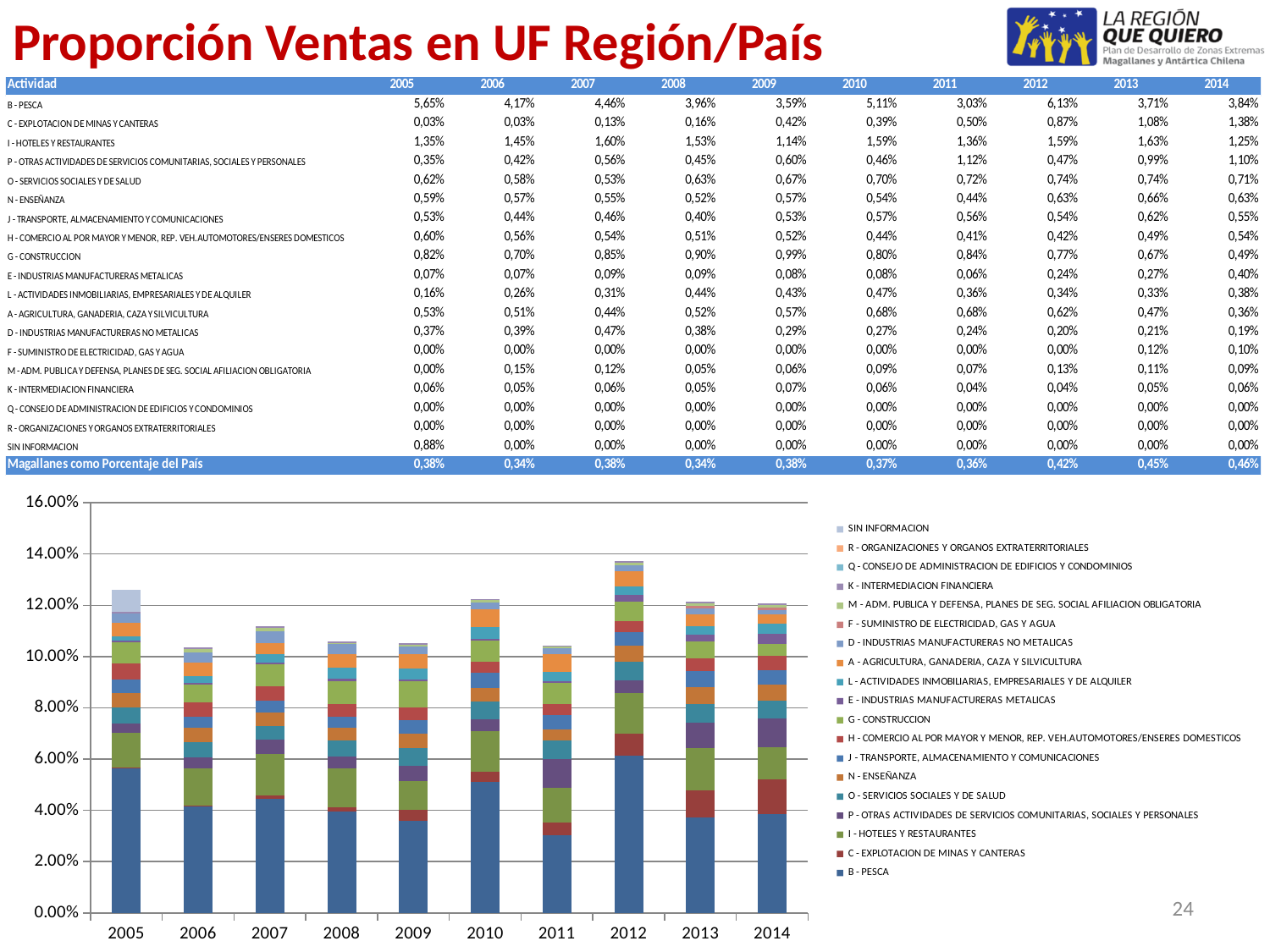
Which year has the tallest stacked bar in the chart? 2012 How many series does the legend of the stacked bar chart list? 19 Which is taller in the stacked bar chart, the bar for 2012 or the bar for 2006? 2012 According to the table, in which year is the value for B - PESCA lowest? 2011 Is the total stacked bar for 2006 greater or less than 12.00%? less Which series is shown as the bottom (dark blue) segment of each stacked bar? B - PESCA What type of chart is shown at the bottom of the slide? stacked bar chart Is the total stacked bar for 2012 greater or less than 12.00%? greater Does the total bar height rise or fall from 2011 to 2012? rise According to the table, what is the value for B - PESCA in 2012? 6,13% How many years are shown on the x axis of the stacked bar chart? 10 Is the total stacked bar for 2005 greater or less than 12.00%? greater